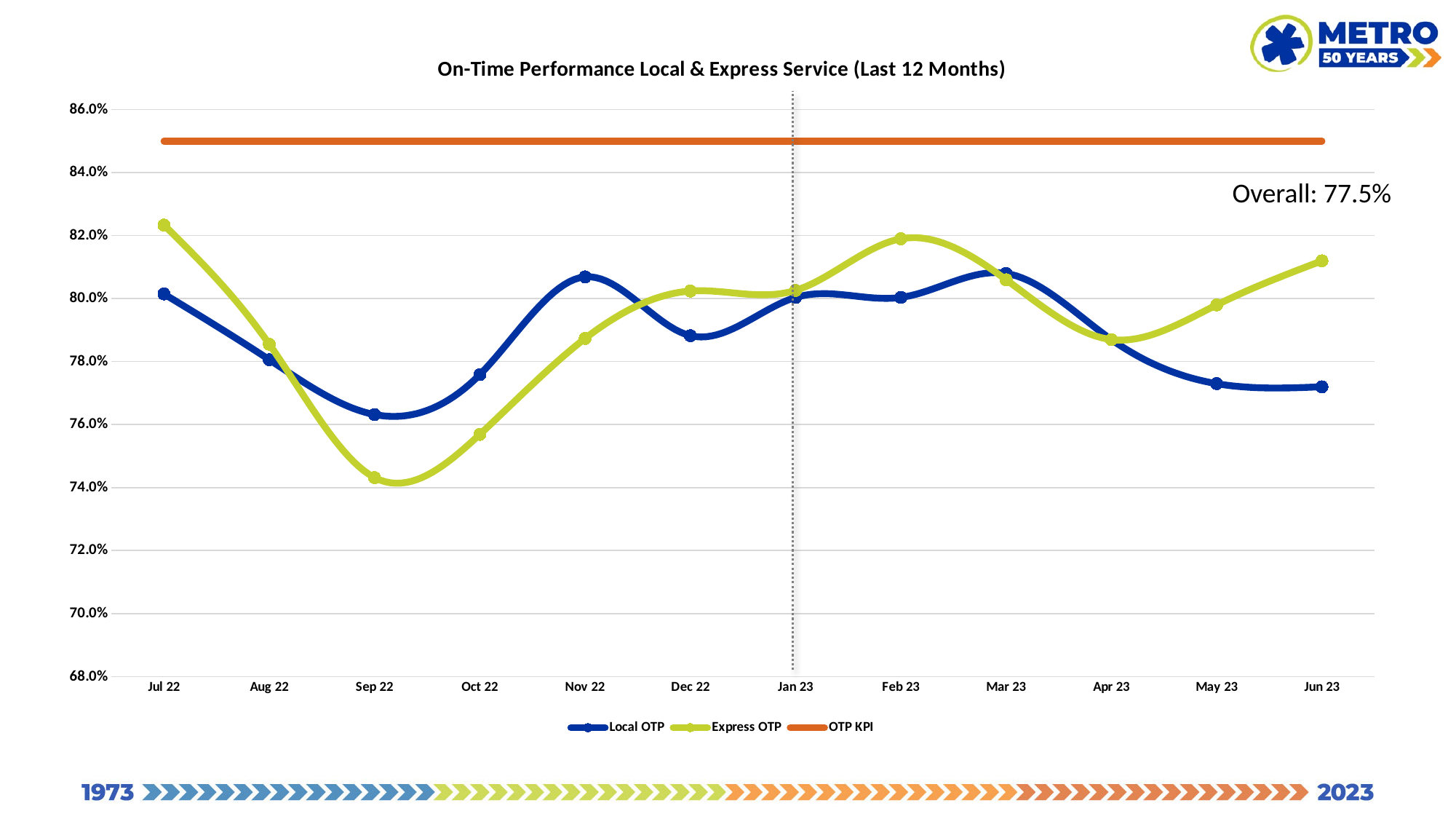
Is the Local OTP value for Nov 22 greater or less than 80.0%? greater How many months are plotted along the x axis? 12 In which month is Express OTP at its highest? Jul 22 In Jun 23, which is larger, Local OTP or Express OTP? Express OTP Is the Express OTP value for Sep 22 greater or less than 76.0%? less In which month is Local OTP at its lowest? Sep 22 Does Local OTP rise or fall from Mar 23 to Jun 23? fall How many series does the legend list? 3 Is the Local OTP value for Jun 23 greater or less than 78.0%? less In which month is Express OTP at its lowest? Sep 22 What kind of chart is shown on the slide? line chart In Sep 22, which is larger, Local OTP or Express OTP? Local OTP